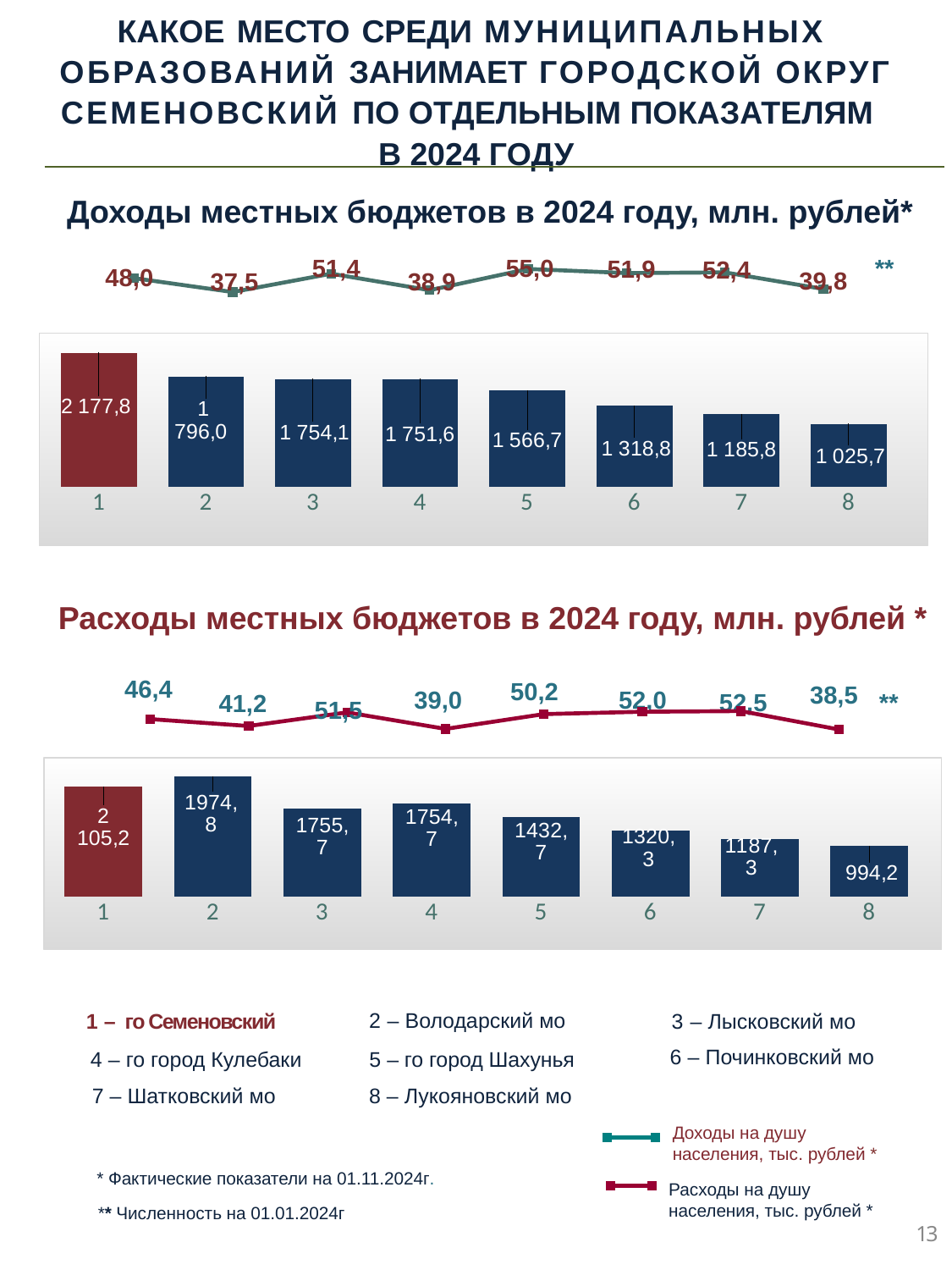
In the chart 'Расходы местных бюджетов в 2024 году, млн. рублей *', do the bar values rise or fall from category 1 to category 8? fall What kind of chart is used for the bars in 'Доходы местных бюджетов в 2024 году, млн. рублей*'? bar chart In the chart 'Расходы местных бюджетов в 2024 году, млн. рублей *', what is the value of the bar for category 1? 2 105,2 In the chart 'Доходы местных бюджетов в 2024 году, млн. рублей*', how many bars are plotted? 8 In the chart 'Доходы местных бюджетов в 2024 году, млн. рублей*', what is the per-capita income (line value) for category 5? 55,0 In the chart 'Доходы местных бюджетов в 2024 году, млн. рублей*', which category has the highest bar? 1 In the chart 'Расходы местных бюджетов в 2024 году, млн. рублей *', which category has the lowest bar? 8 In the chart 'Расходы местных бюджетов в 2024 году, млн. рублей *', what is the per-capita expenditure (line value) for category 7? 52,5 In the chart 'Расходы местных бюджетов в 2024 году, млн. рублей *', which is larger: the bar for category 2 or the bar for category 3? category 2 In the chart 'Доходы местных бюджетов в 2024 году, млн. рублей*', what is the value of the bar for category 8? 1 025,7 In the chart 'Доходы местных бюджетов в 2024 году, млн. рублей*', what is the value of the bar for category 1? 2 177,8 In the chart 'Доходы местных бюджетов в 2024 году, млн. рублей*', what is the difference between the bars for category 1 and category 2? 381,8